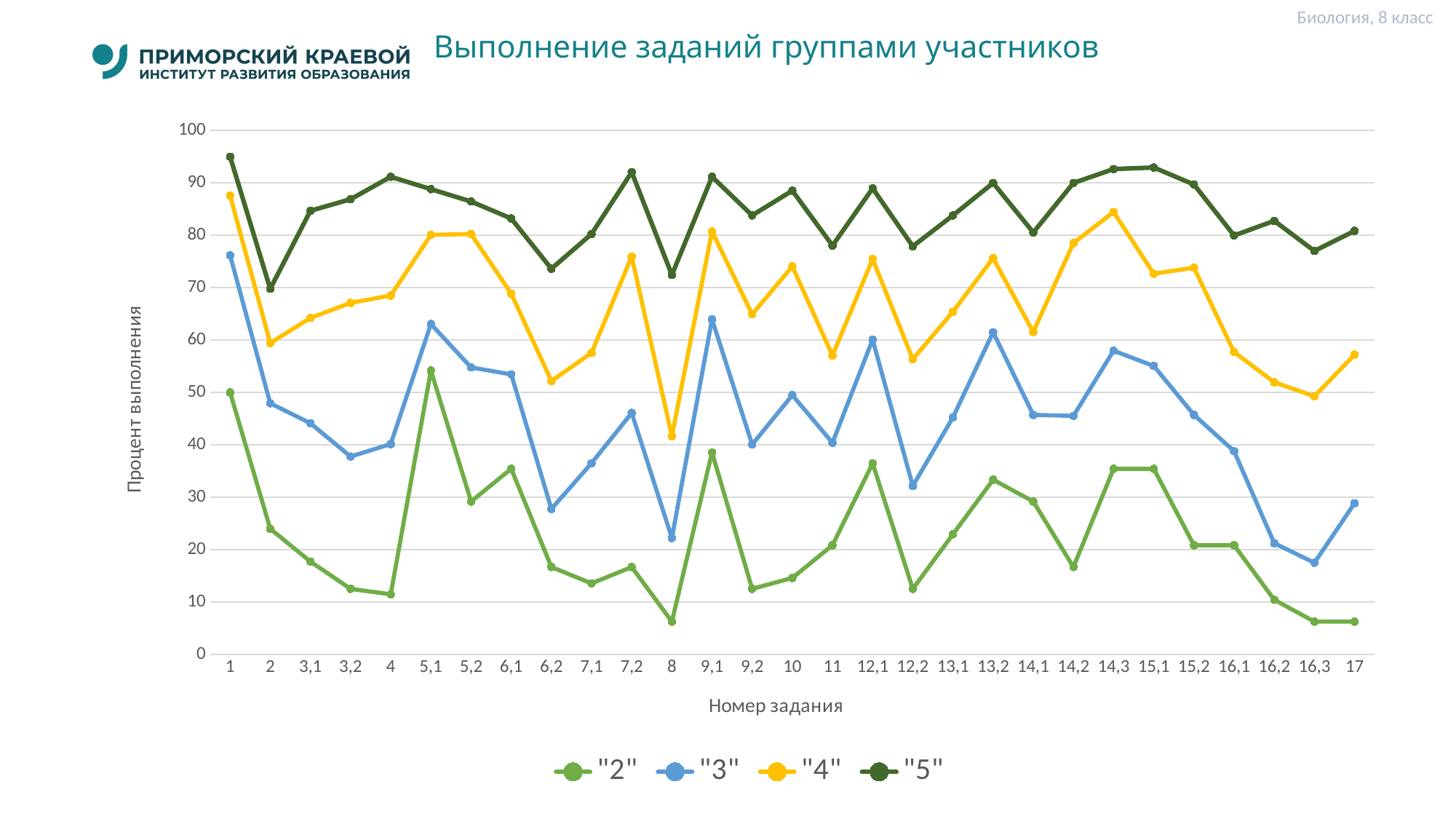
For series "4", at which task number is the value lowest? 8 Which series has the highest value at task 1? "5" Is the value for series "2" at task 8 greater or less than 10? less For series "2", at which task number is the value highest? 5,1 How many series does the legend list? 4 How many task numbers are shown along the x axis? 29 Is the value for series "3" at task 1 greater or less than 70? greater What is the label of the y axis? Процент выполнения Is the value for series "5" at task 1 greater or less than 90? greater At task 8, which series has the larger value, "3" or "2"? "3" What kind of chart is shown on the slide? line chart For series "3", at which task number is the value lowest? 16,3